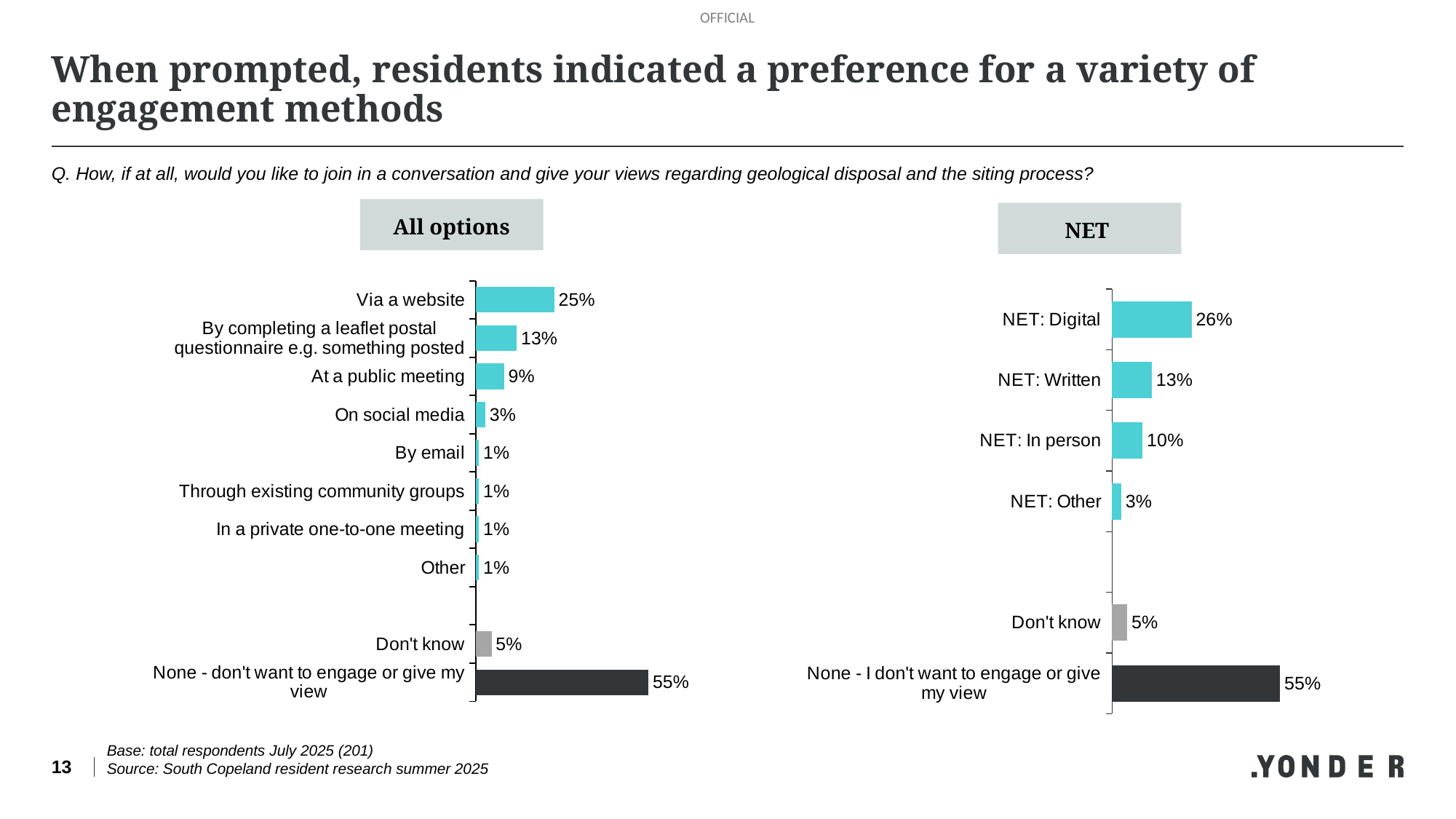
What type of chart is the 'All options' chart? Bar chart In the 'All options' chart, what is the difference between 'Via a website' and 'By completing a leaflet postal questionnaire e.g. something posted'? 12% In the 'NET' chart, what is the difference between 'NET: Digital' and 'NET: Written'? 13% In the 'NET' chart, what is the value for 'NET: Digital'? 26% In the 'NET' chart, which NET category has the lowest value? NET: Other In the 'All options' chart, what colour is the 'Don't know' bar? Grey In the 'All options' chart, what is the value for 'At a public meeting'? 9% In the 'All options' chart, what percentage of respondents chose 'Via a website'? 25% In the 'All options' chart, which is larger: 'On social media' or 'At a public meeting'? At a public meeting How many categories are plotted in the 'NET' chart? 6 In the 'All options' chart, which category has the highest value? None - don't want to engage or give my view In the 'NET' chart, what is the value for 'NET: In person'? 10%